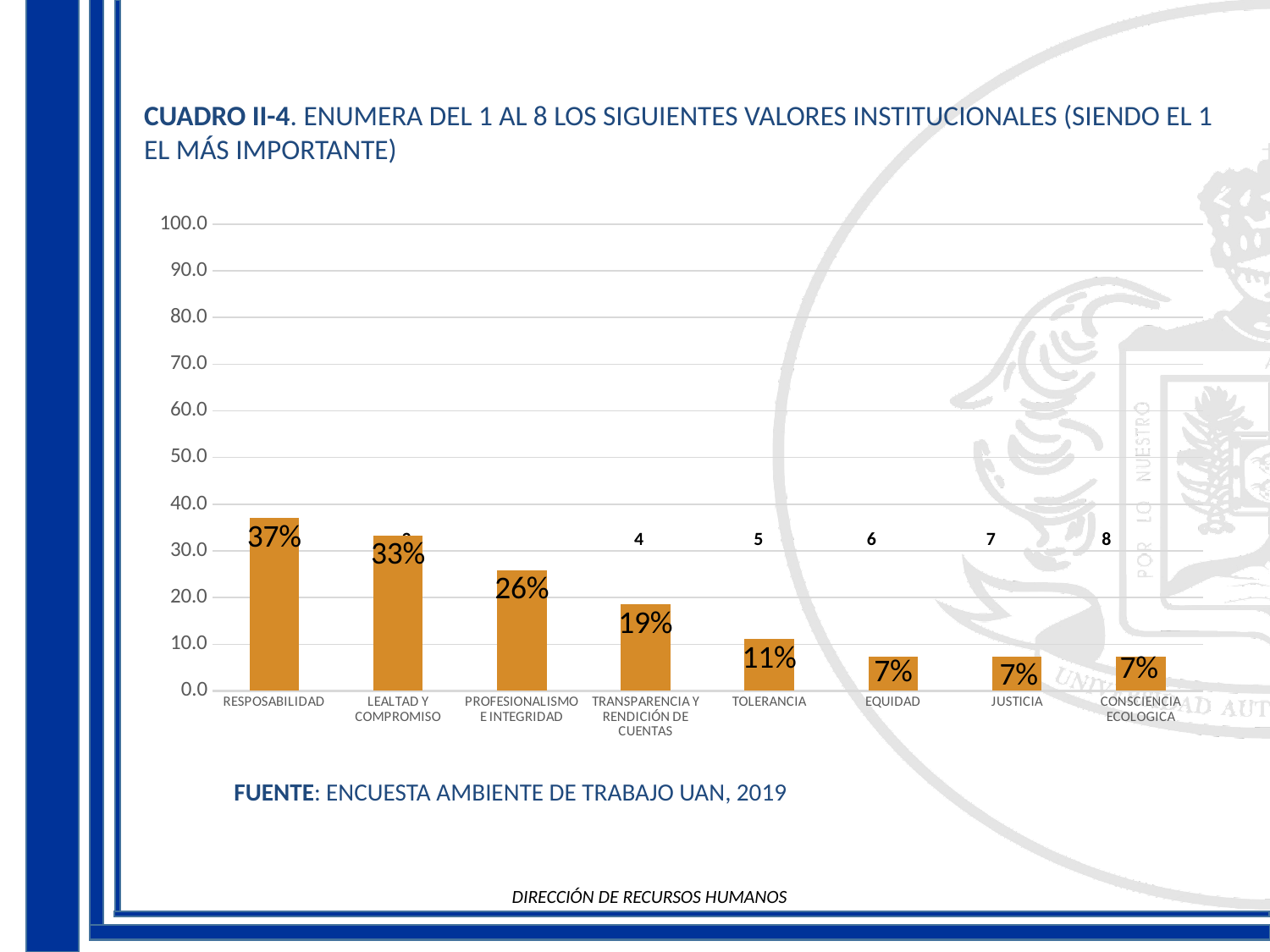
What is the value shown for RESPOSABILIDAD? 37% Do the values rise or fall from left to right along the x axis? Fall What is the value shown for PROFESIONALISMO E INTEGRIDAD? 26% How many categories are shown on the x axis? 8 What is the difference between the values for RESPOSABILIDAD and LEALTAD Y COMPROMISO? 4% What kind of chart is shown on the slide? Bar chart What is the value shown for TRANSPARENCIA Y RENDICIÓN DE CUENTAS? 19% Which is larger, the value for LEALTAD Y COMPROMISO or the value for TRANSPARENCIA Y RENDICIÓN DE CUENTAS? LEALTAD Y COMPROMISO Which category has the highest value? RESPOSABILIDAD What is the difference between the values for PROFESIONALISMO E INTEGRIDAD and TOLERANCIA? 15% What source is cited below the chart? ENCUESTA AMBIENTE DE TRABAJO UAN, 2019 What is the value shown for TOLERANCIA? 11%